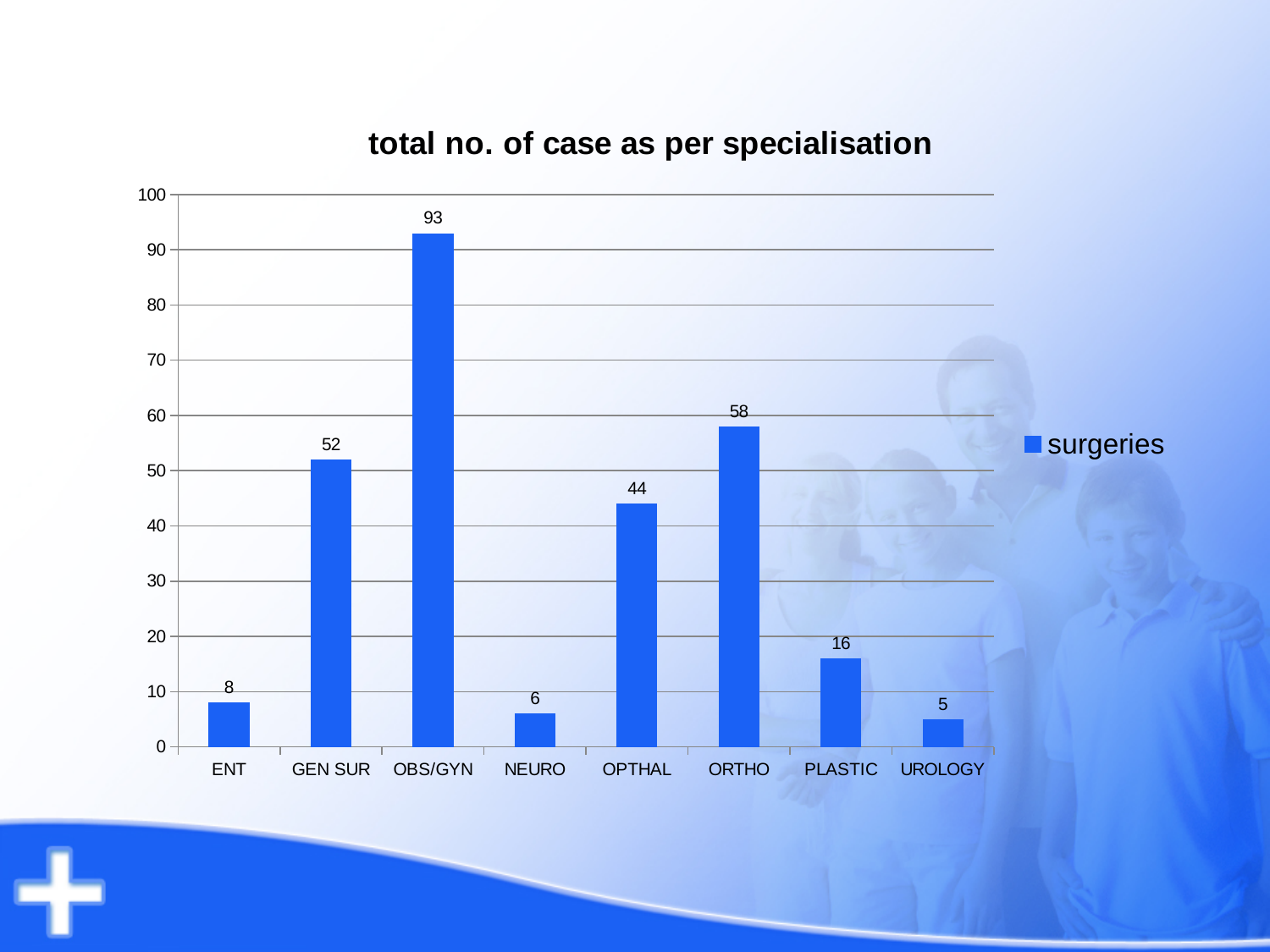
Is the value for ENT greater or less than 10? less How many series does the legend list? 1 What is the number of surgeries for PLASTIC? 16 What kind of chart is shown on the slide? bar chart Which specialisation has the highest number of surgeries? OBS/GYN What is the difference between the surgeries for ORTHO and OPTHAL? 14 How many specialisations are shown on the x axis? 8 Which has more surgeries, GEN SUR or OPTHAL? GEN SUR Which specialisation has the lowest number of surgeries? UROLOGY What is the number of surgeries for ORTHO? 58 What is the number of surgeries for OBS/GYN? 93 What is the difference between the surgeries for OBS/GYN and GEN SUR? 41